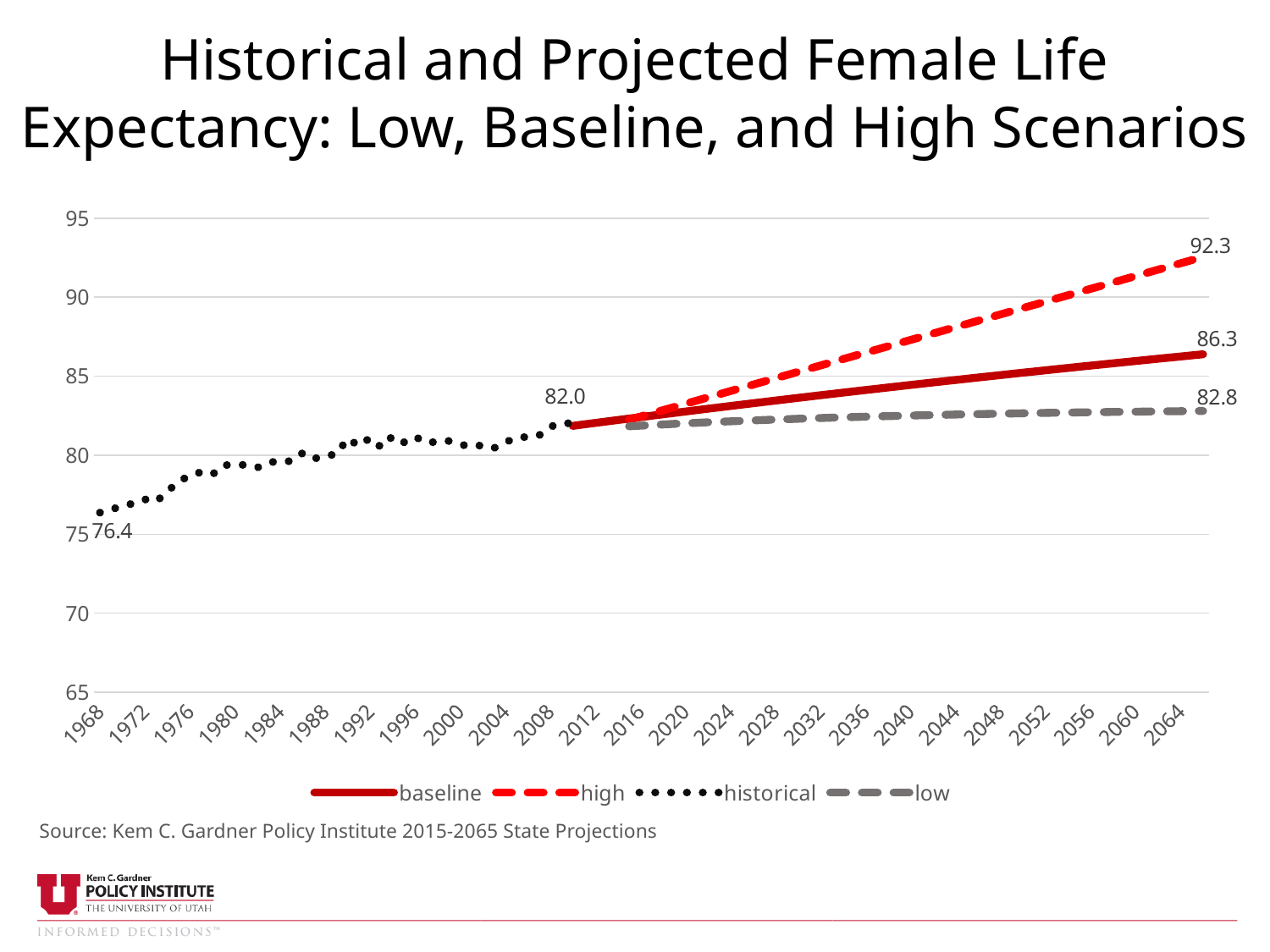
What is the final labelled value of the high scenario line? 92.3 What kind of chart is shown on the slide? line chart Does the historical series generally rise or fall from 1968 to its end? rise Is the value of the high scenario line at 2040 greater or less than 85? greater Which scenario line ends at the highest value? high What is the final labelled value of the low scenario line? 82.8 By how much does the labelled end of the historical series exceed its labelled start? 5.6 How many series does the legend list? 4 What is the difference between the final values of the high and low scenarios? 9.5 What is the labelled value at the end of the historical series? 82.0 What is the labelled value at the start of the historical series in 1968? 76.4 What is the final labelled value of the baseline scenario line? 86.3